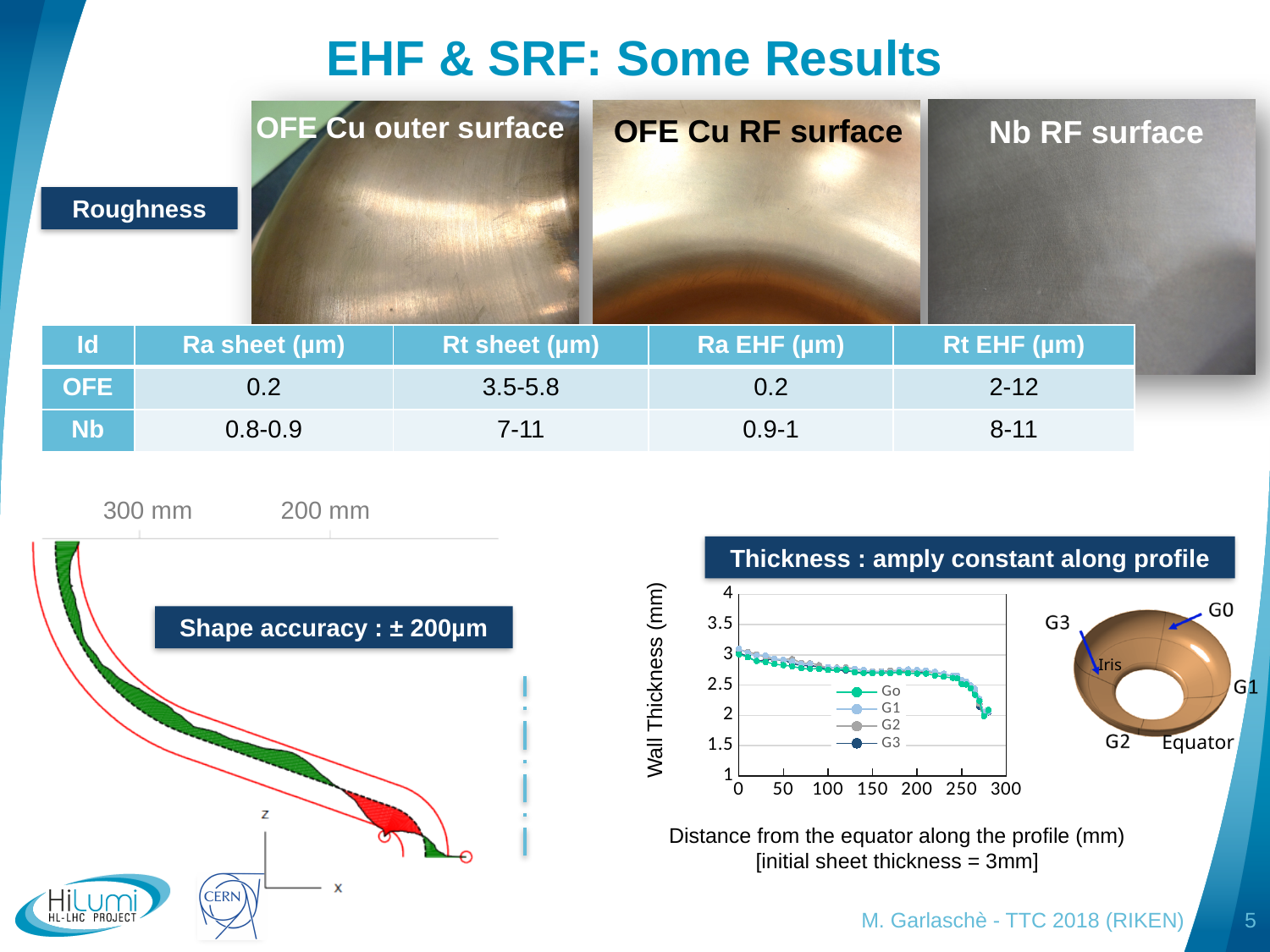
In the wall thickness chart, is the wall thickness at a distance of 0 mm greater or less than 2.5 mm? greater What kind of chart is shown under the heading "Thickness : amply constant along profile"? line chart In the wall thickness chart, is the wall thickness at a distance of 200 mm greater or less than 2 mm? greater In the wall thickness chart, is the wall thickness at the far end of the profile (around 280 mm) greater or less than 2.5 mm? less What is the label of the vertical axis of the wall thickness chart? Wall Thickness (mm) How many series does the legend of the wall thickness chart list? 4 What are the series names listed in the legend of the wall thickness chart? Go, G1, G2, G3 In the wall thickness chart, do the values rise or fall as the distance from the equator increases? fall What is the maximum value shown on the horizontal axis of the wall thickness chart? 300